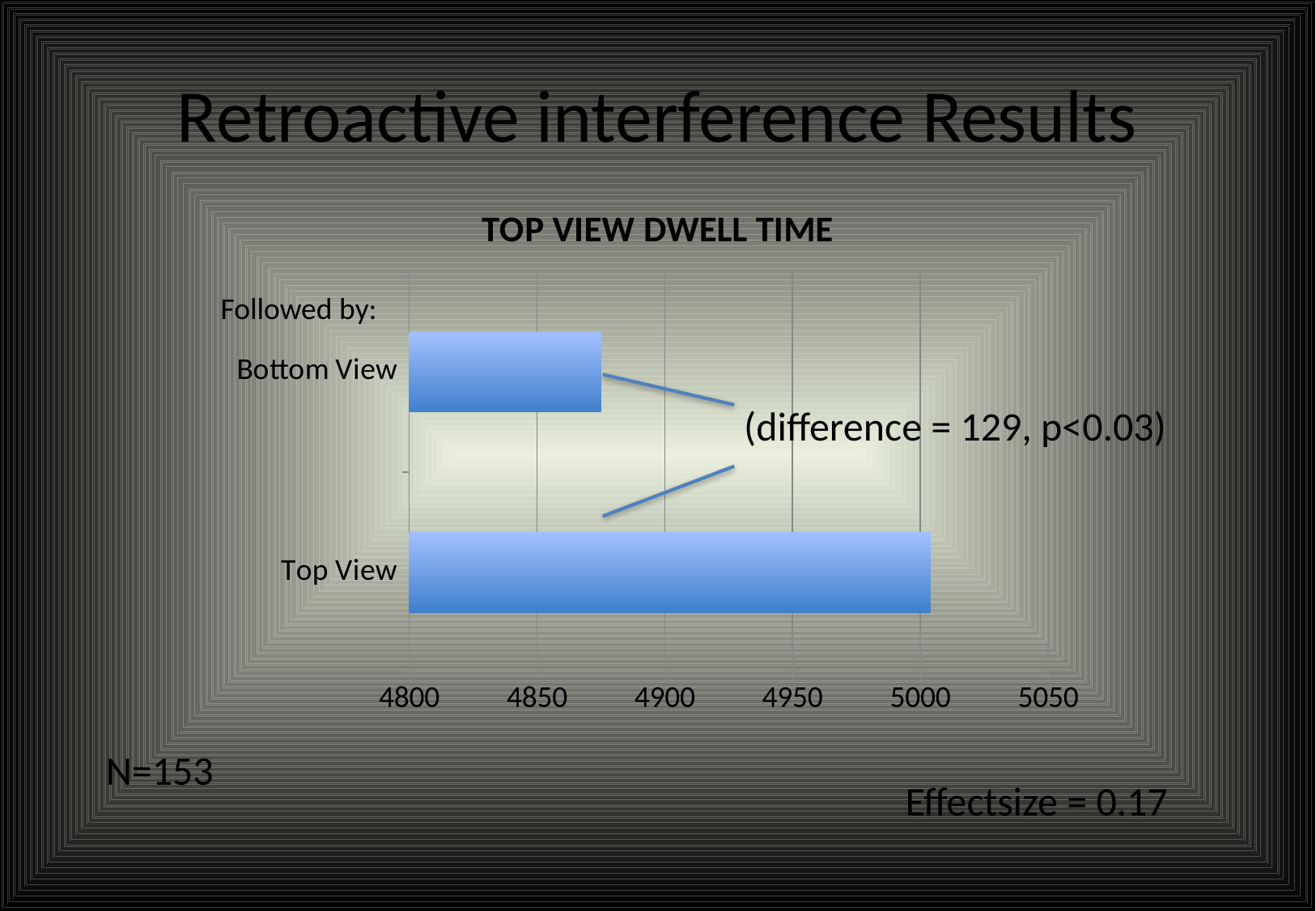
Which category has the lowest dwell time? Bottom View What kind of chart is shown on the slide? bar chart What is the title of the chart? TOP VIEW DWELL TIME How many categories are plotted in the chart? 2 Is the value for Bottom View greater or less than 4900? less Is the value for Bottom View greater or less than 4850? greater Is the value for Top View greater or less than 5050? less Which is larger, the value for Top View or the value for Bottom View? Top View Which category has the highest dwell time? Top View What difference between the two bars is stated in the annotation on the chart? 129